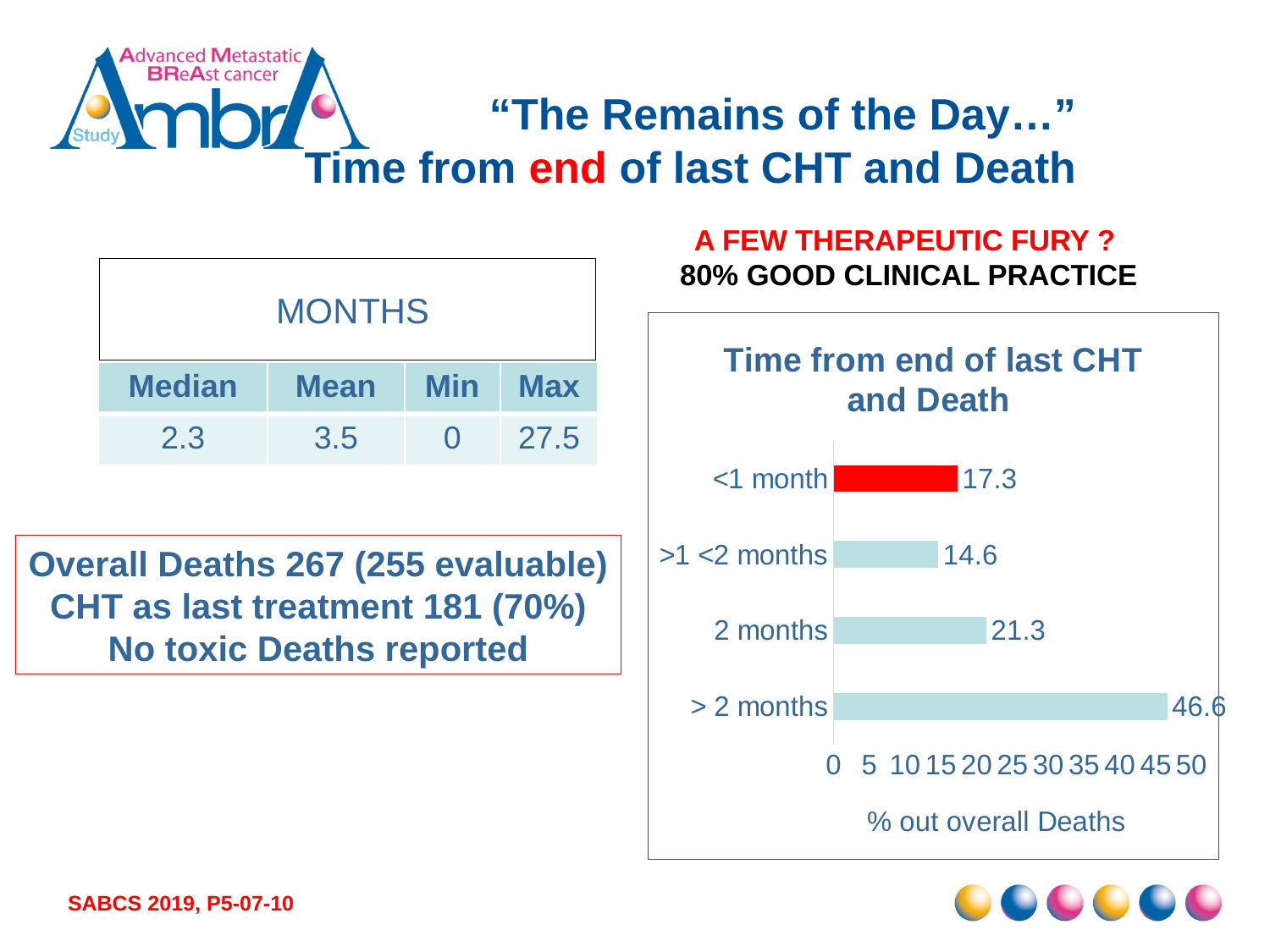
What is the value for "<1 month" in the chart? 17.3 What is the difference between the values for "> 2 months" and "2 months"? 25.3 How many categories are shown in the chart? 4 What is the value for "> 2 months" in the chart? 46.6 What is the value for "2 months" in the chart? 21.3 What kind of chart is shown on the slide? Bar chart What is the title of the chart? Time from end of last CHT and Death Is the value for "> 2 months" greater or less than 40? greater Which is larger, the value for "<1 month" or the value for ">1 <2 months"? <1 month Which category has the lowest value in the chart? >1 <2 months What is the value for ">1 <2 months" in the chart? 14.6 Which category has the highest value in the chart? > 2 months